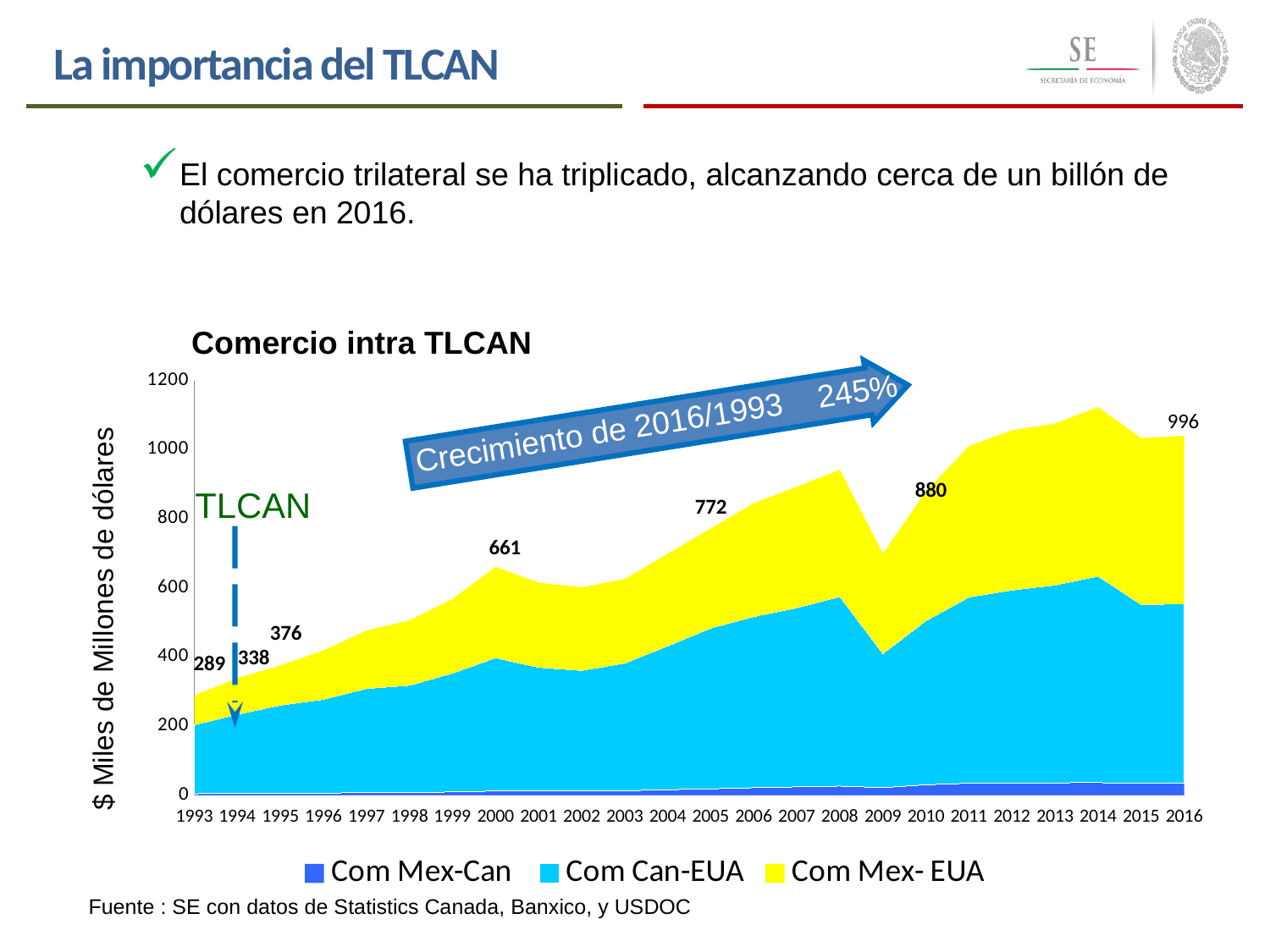
How many years are shown on the x axis of the chart? 24 What is the title of the chart? Comercio intra TLCAN What is the total intra-TLCAN trade value labelled for 2005? 772 Overall, does total intra-TLCAN trade rise or fall from 1993 to 2016? Rise What is the total intra-TLCAN trade value labelled for 2010? 880 What kind of chart is shown on the slide? Stacked area chart What is the total intra-TLCAN trade value labelled for 1993? 289 How many series does the chart's legend list? 3 Which is larger, the labelled total for 2000 or the labelled total for 1995? 2000 Is the total intra-TLCAN trade value for 2009 greater or less than 800? less What is the total intra-TLCAN trade value labelled for 2016? 996 What is the difference between the labelled total for 2016 and the labelled total for 1993? 707